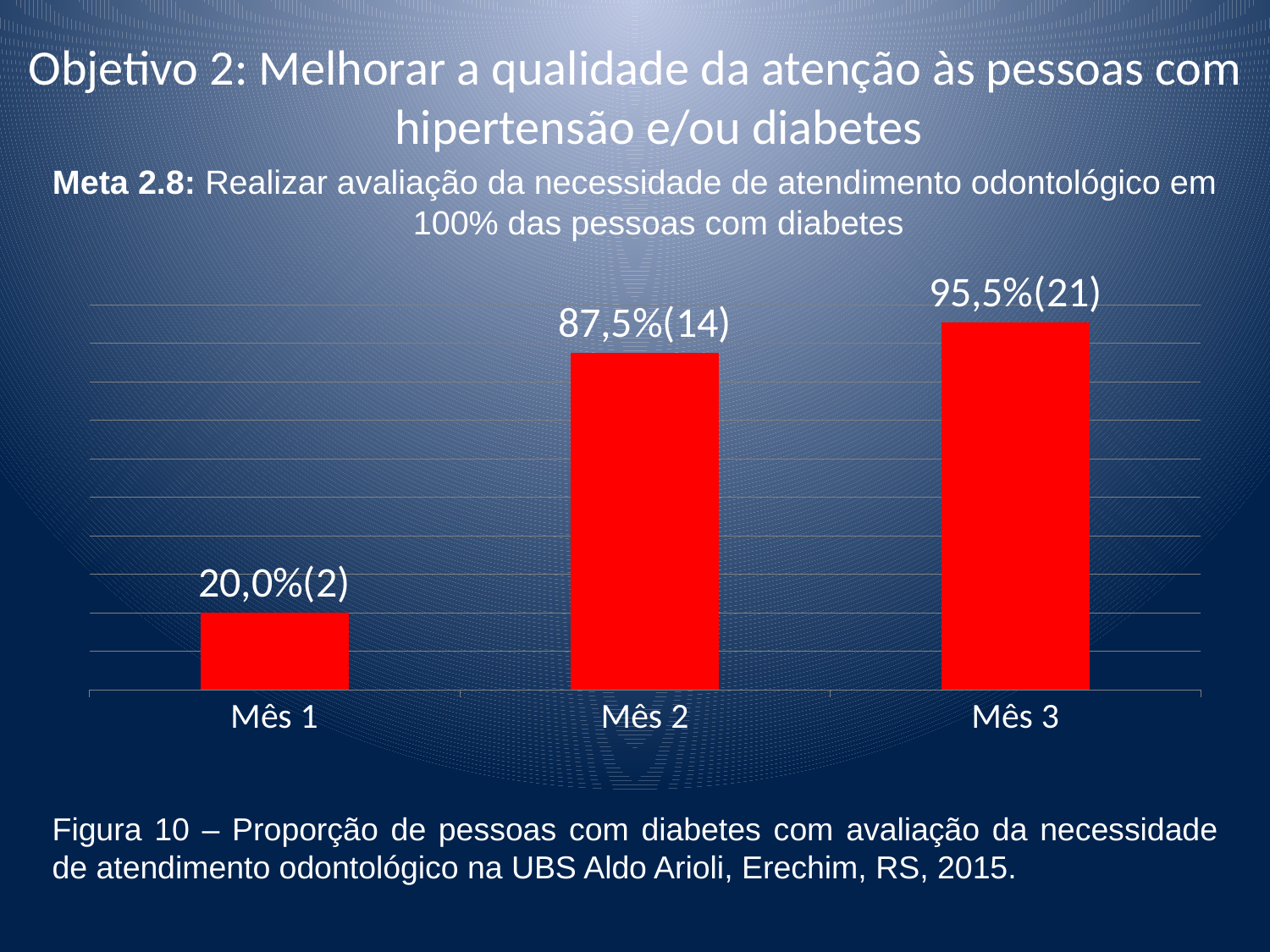
Which month has the highest value? Mês 3 Which month has the lowest value? Mês 1 What is the difference in percentage points between Mês 3 and Mês 2? 8,0 What is the difference in percentage points between Mês 2 and Mês 1? 67,5 What is the value shown for Mês 3? 95,5%(21) How many months (categories) are shown in the chart? 3 What kind of chart is shown on the slide? Bar chart Do the values rise or fall from Mês 1 to Mês 3? Rise Which is larger, the value for Mês 1 or the value for Mês 2? Mês 2 What is the value shown for Mês 2? 87,5%(14) What colour are the bars in the chart? Red What is the value shown for Mês 1? 20,0%(2)